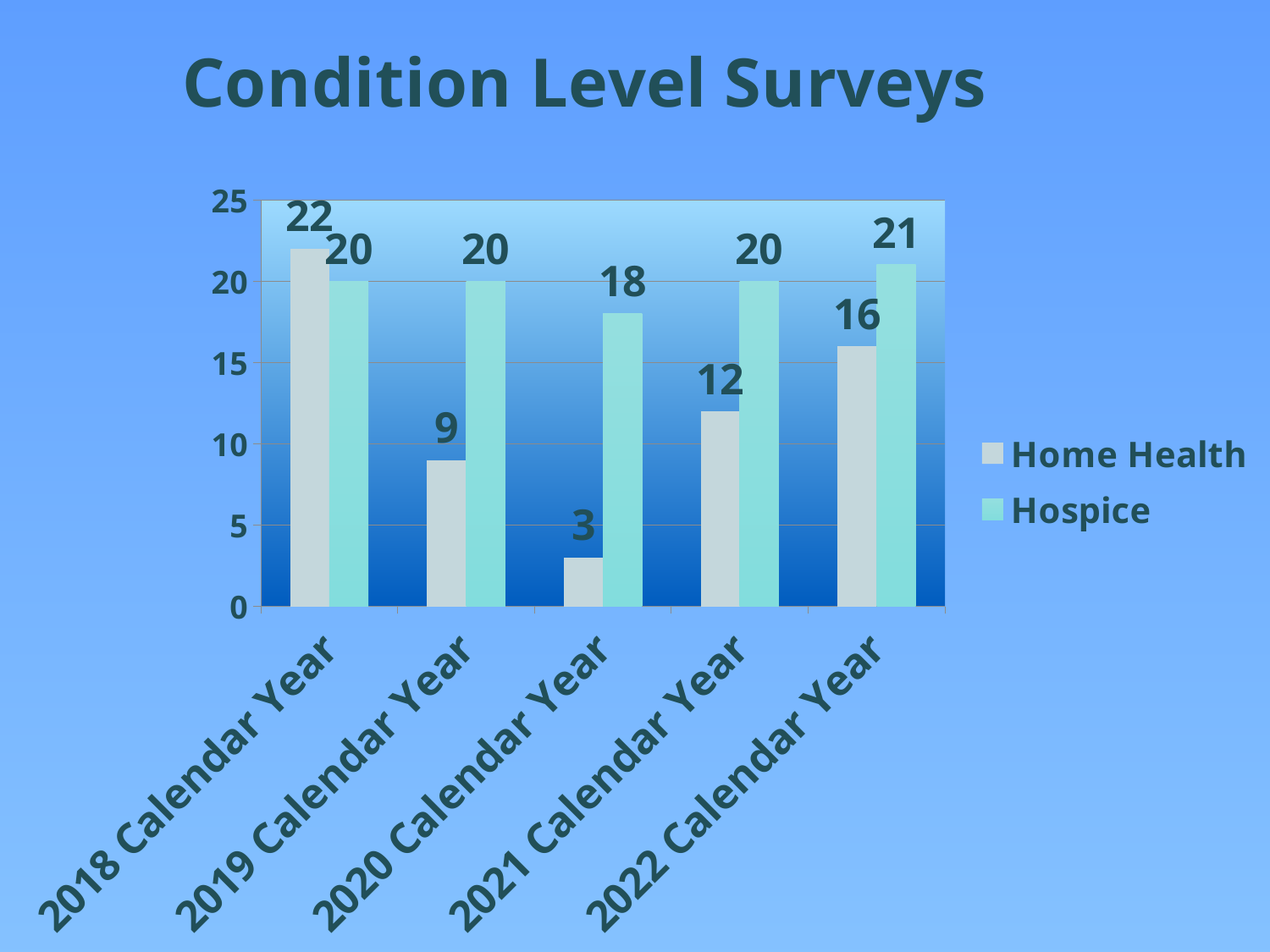
What is the Hospice value for 2020 Calendar Year? 18 What is the title of the chart? Condition Level Surveys What is the difference between the Hospice and Home Health values for 2019 Calendar Year? 11 What is the Home Health value for 2021 Calendar Year? 12 Which is larger for 2018 Calendar Year, Home Health or Hospice? Home Health How many calendar years are shown on the x axis? 5 Which calendar year has the lowest Home Health value? 2020 Calendar Year What kind of chart is shown on the slide? bar chart How many series does the legend list? 2 Is the Home Health value for 2022 Calendar Year greater or less than 15? greater Which calendar year has the highest Hospice value? 2022 Calendar Year What is the Home Health value for 2018 Calendar Year? 22